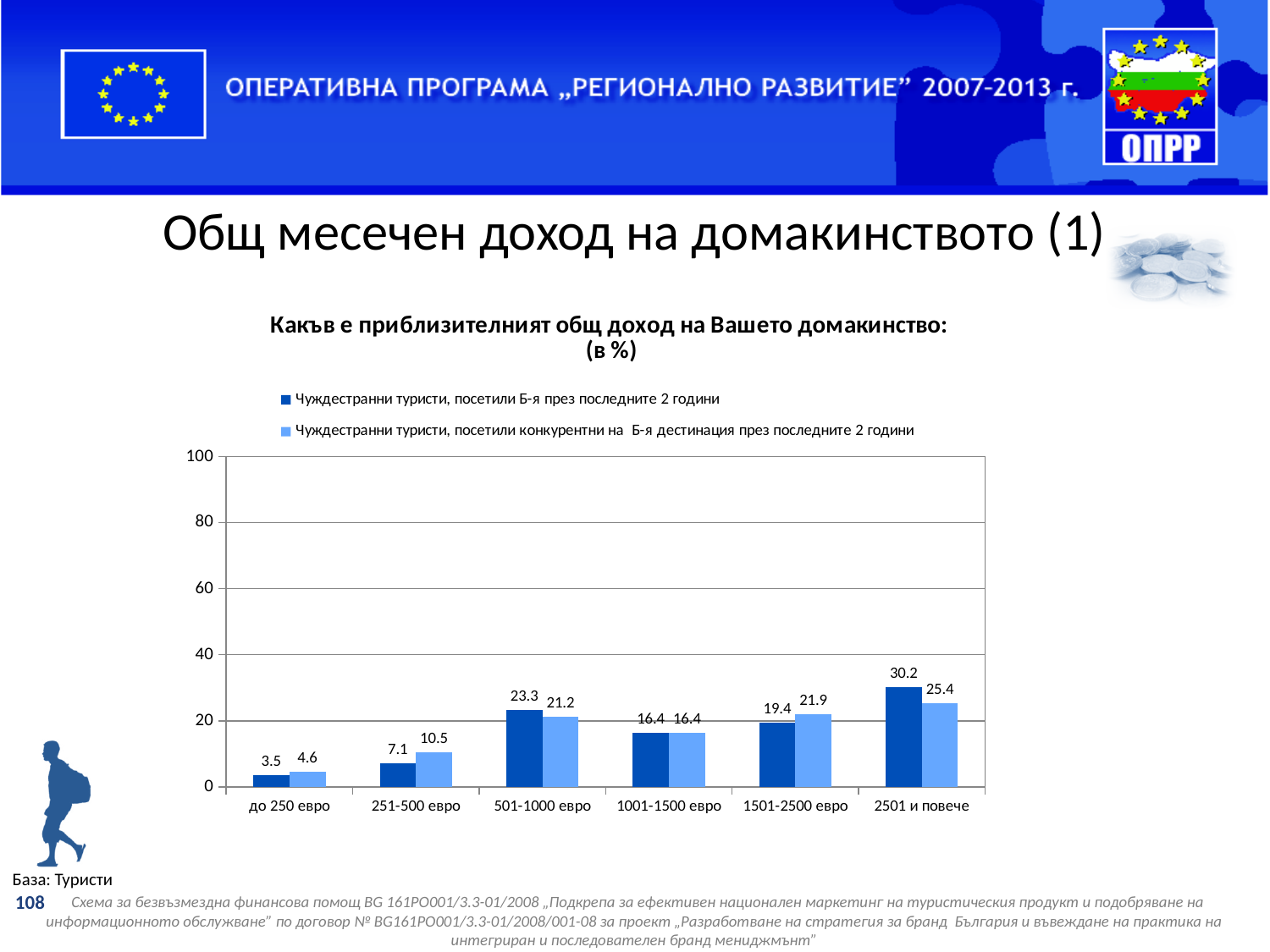
Is the value for '2501 и повече' for the series 'Чуждестранни туристи, посетили Б-я през последните 2 години' greater or less than 20? greater Which income category has the highest value for the series 'Чуждестранни туристи, посетили Б-я през последните 2 години'? 2501 и повече What is the value for 'до 250 евро' for the series 'Чуждестранни туристи, посетили Б-я през последните 2 години'? 3.5 Which income category has the lowest value for the series 'Чуждестранни туристи, посетили конкурентни на Б-я дестинация през последните 2 години'? до 250 евро What is the value for '1001-1500 евро' for both series? 16.4 What is the difference between the two series for the category '2501 и повече'? 4.8 What kind of chart is shown on the slide? bar chart How many income categories are shown on the x axis? 6 What is the value for '2501 и повече' for the series 'Чуждестранни туристи, посетили конкурентни на Б-я дестинация през последните 2 години'? 25.4 For the category '501-1000 евро', which series has the larger value? Чуждестранни туристи, посетили Б-я през последните 2 години How many series does the legend list? 2 What is the value for '1501-2500 евро' for the series 'Чуждестранни туристи, посетили Б-я през последните 2 години'? 19.4